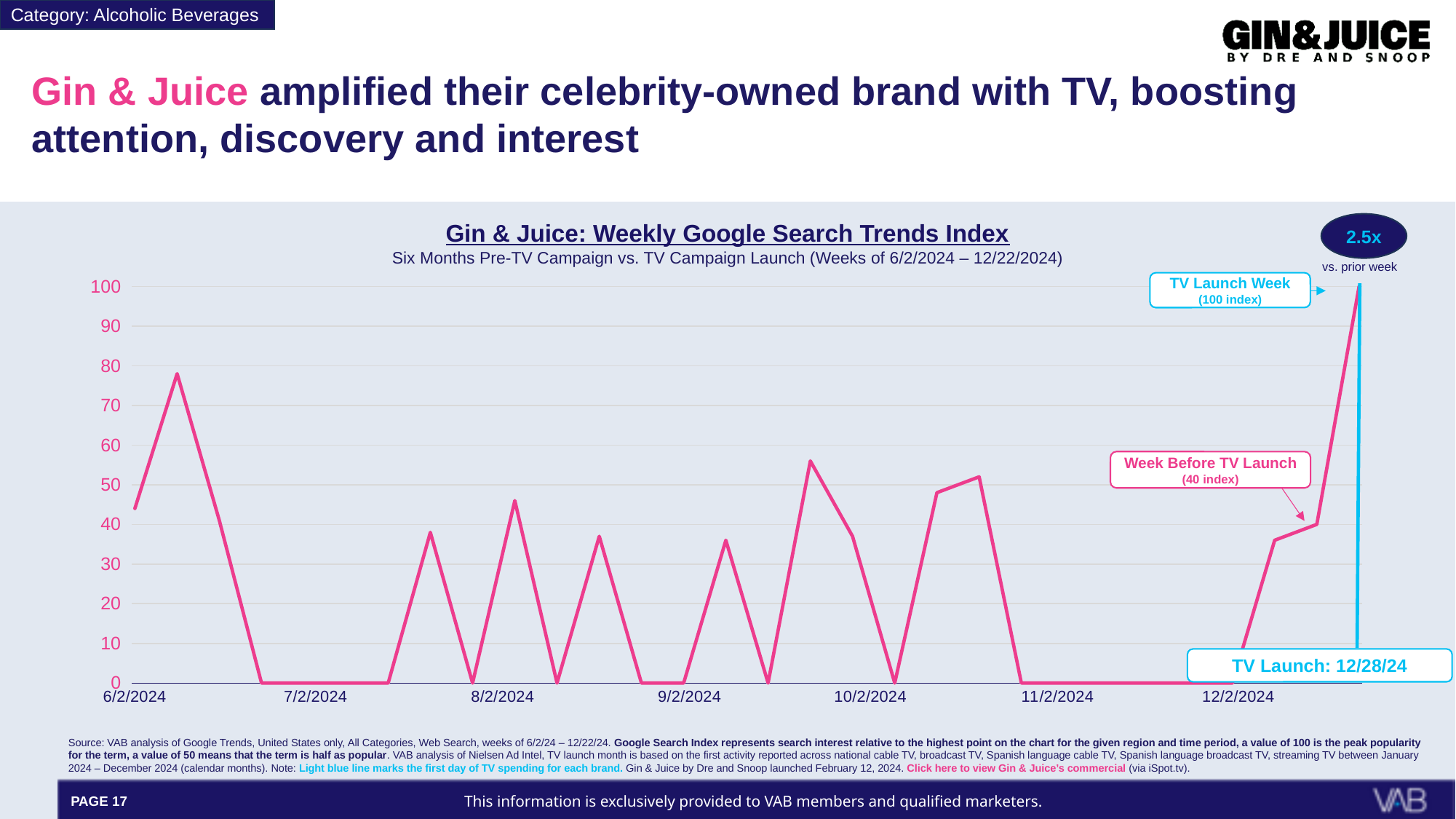
How many date labels are shown on the x axis? 7 Which is larger, the index for the TV Launch Week or the index for the Week Before TV Launch? TV Launch Week Is the search index value at 6/2/2024 greater or less than 50? less What multiplier versus the prior week is shown in the badge at the top right of the chart? 2.5x What is the search index value for the TV Launch Week? 100 What is the difference between the TV Launch Week index and the Week Before TV Launch index? 60 What is the search index value for the Week Before TV Launch? 40 Is the search index value at 12/2/2024 greater or less than 10? less Which week has the highest search index value on the chart? TV Launch Week What kind of chart is shown on the slide? line chart Does the search index rise or fall from the Week Before TV Launch to the TV Launch Week? rise What is the search index value at 7/2/2024? 0